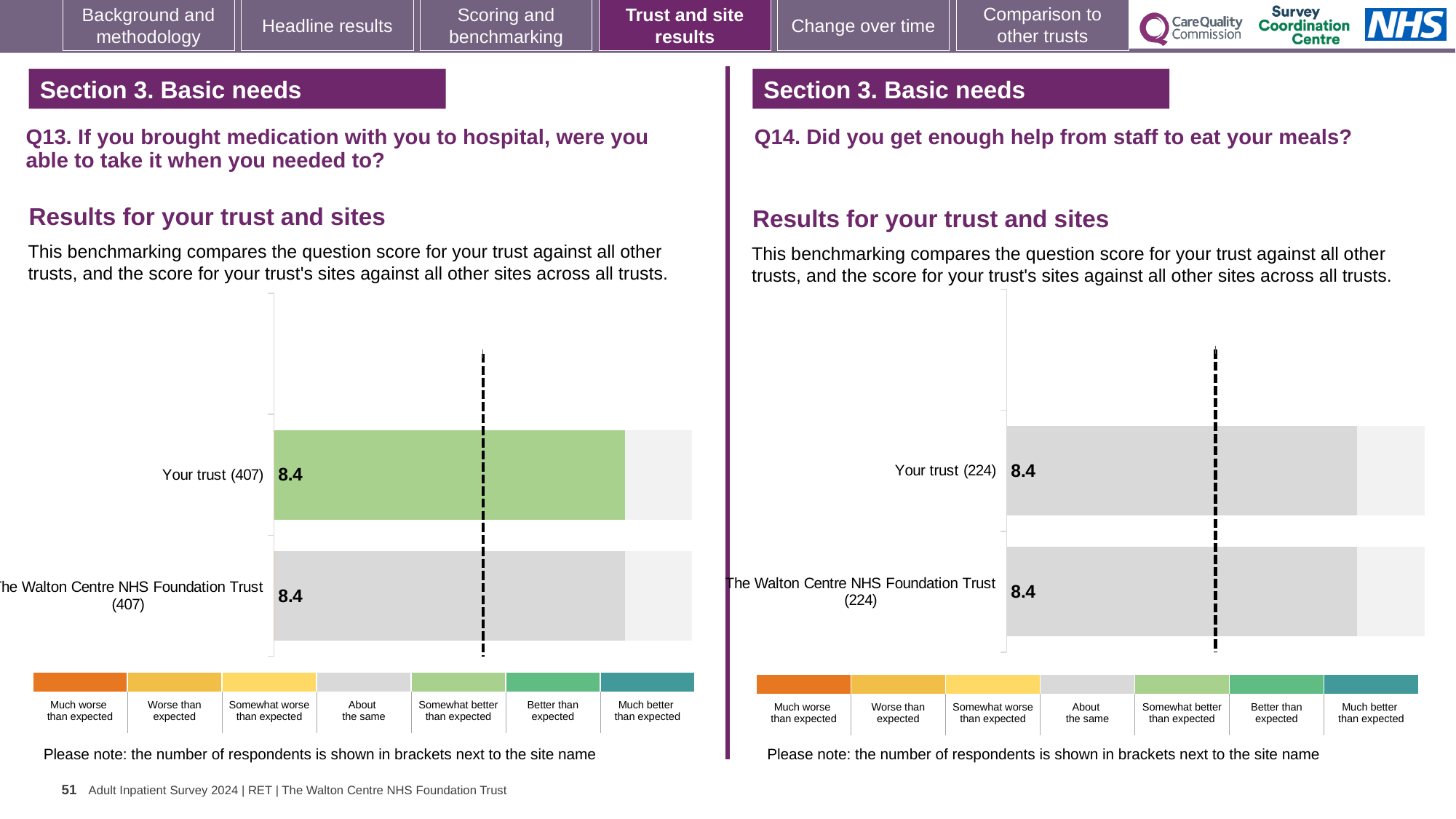
On the Q13 chart (left), what is the difference between the score for Your trust (407) and the score for The Walton Centre NHS Foundation Trust (407)? 0.0 How many bars are plotted on the Q13 chart (left)? 2 On the Q13 chart (left), which benchmark category does the colour of the Your trust (407) bar correspond to? Somewhat better than expected On the Q14 chart (right), what is the difference between the score for Your trust (224) and the score for The Walton Centre NHS Foundation Trust (224)? 0.0 How many respondents are shown in brackets for Your trust on the Q14 chart (right)? 224 On the Q13 chart (left), what is the score for The Walton Centre NHS Foundation Trust (407)? 8.4 On the Q14 chart (right), what is the score for The Walton Centre NHS Foundation Trust (224)? 8.4 On the Q14 chart (right), which benchmark category does the colour of the Your trust (224) bar correspond to? About the same What kind of chart is the Q13 chart (left)? Bar chart How many bars are plotted on the Q14 chart (right)? 2 On the Q14 chart (right), what is the score for Your trust (224)? 8.4 On the Q13 chart (left), what is the score for Your trust (407)? 8.4